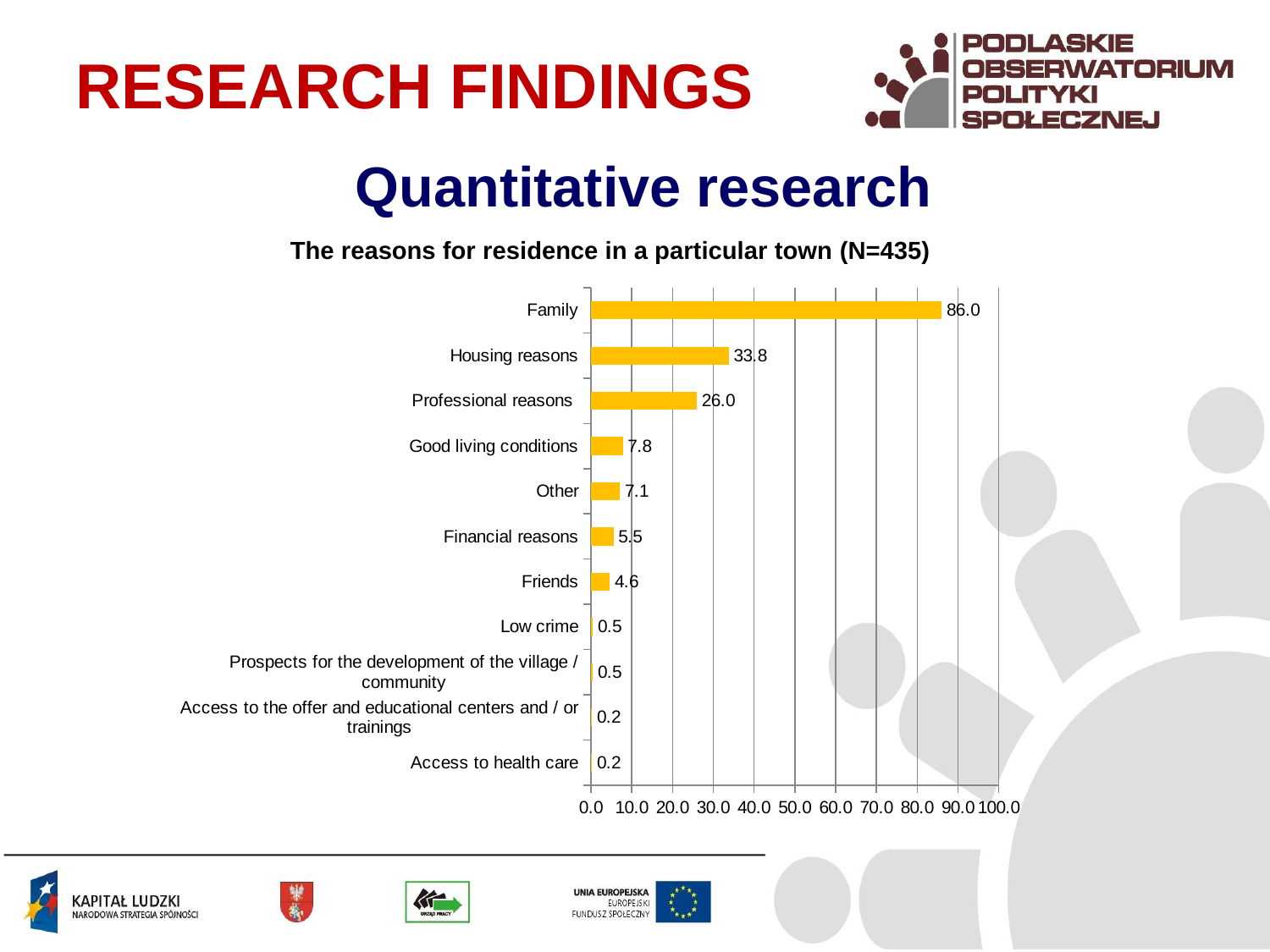
What is the value for Friends? 4.6 How many categories are shown in the chart? 11 What is the title of the chart? The reasons for residence in a particular town (N=435) Is the value for Professional reasons greater or less than 30.0? less What is the value for Family? 86.0 What is the difference between the values for Family and Housing reasons? 52.2 What is the value for Housing reasons? 33.8 What kind of chart is shown on the slide? bar chart What is the value for Professional reasons? 26.0 What is the difference between the values for Good living conditions and Other? 0.7 Which reason has the highest value? Family Which is larger, the value for Financial reasons or the value for Friends? Financial reasons